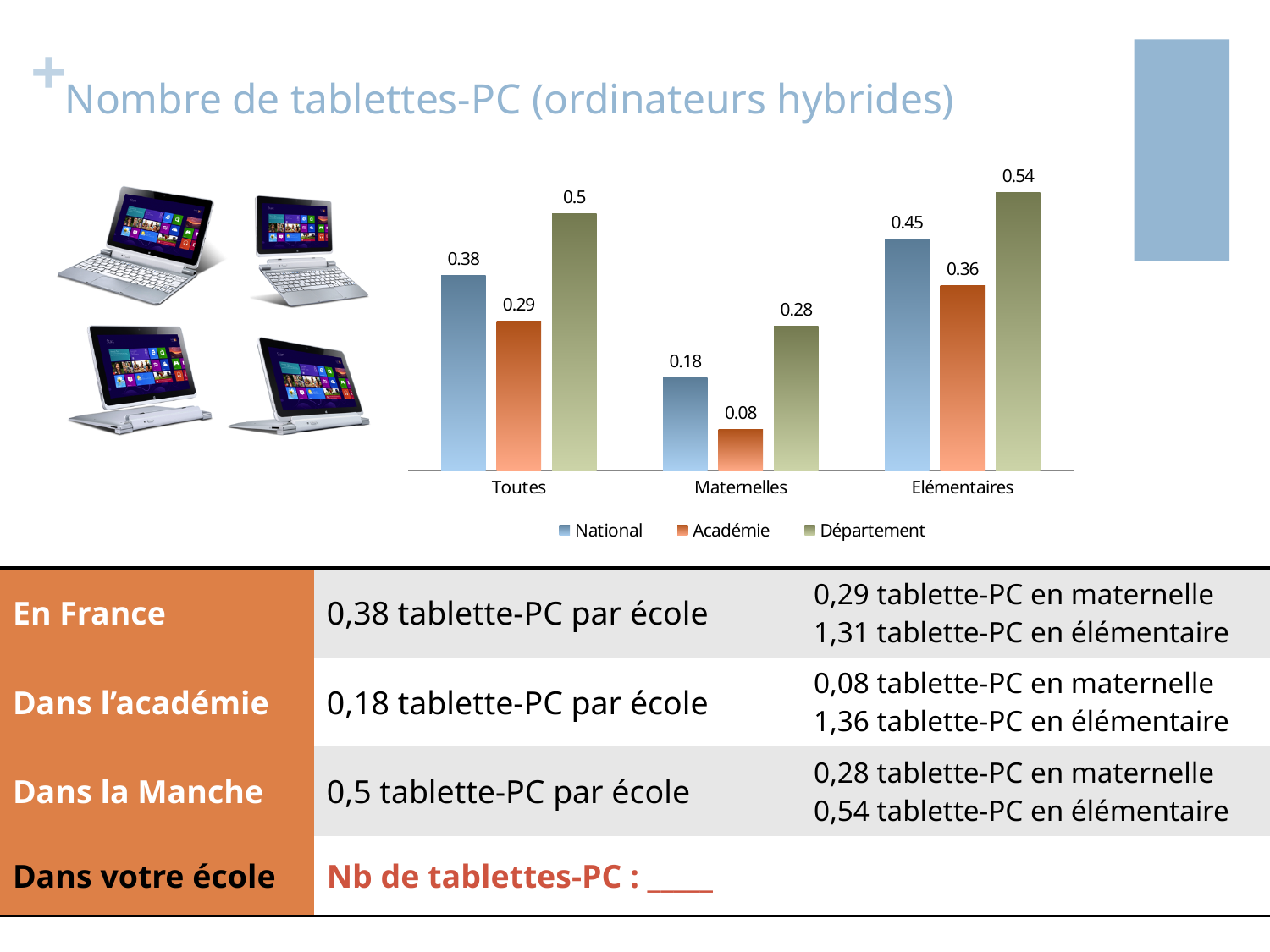
What kind of chart is shown on the slide? Bar chart What is the difference between the National values for Elémentaires and Maternelles? 0.27 What is the value for Académie in the Maternelles category? 0.08 Which series has the highest value in the Toutes category? Département How many series does the legend list? 3 Which is larger: the Académie value for Toutes or the Département value for Maternelles? Académie value for Toutes What is the value for National in the Toutes category? 0.38 Which series has the lowest value in the Maternelles category? Académie What is the difference between the Département and National values in the Toutes category? 0.12 What is the value for Département in the Elémentaires category? 0.54 How many categories are shown on the x axis? 3 What is the value for Académie in the Elémentaires category? 0.36